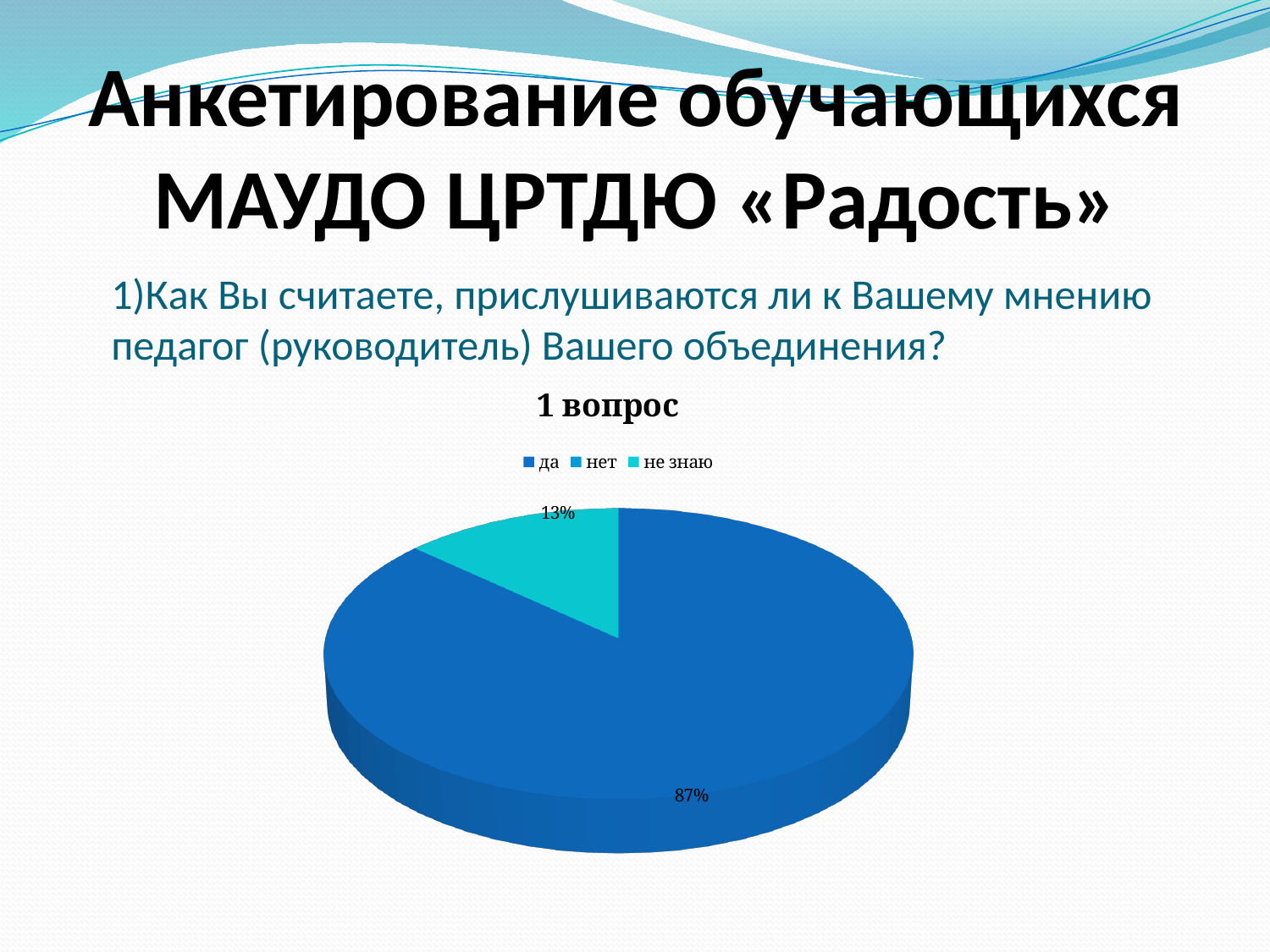
Is the share for "да" greater or less than 50%? greater How many entries does the chart legend list? 3 Which is larger, the slice for "да" or the slice for "не знаю"? да What share of the pie is labelled for the "не знаю" slice? 13% Which answer option has the largest slice of the pie? да What share of the pie is labelled for the "да" slice? 87% Which legend entry is shown in the dark blue colour? да What is the title of the chart? 1 вопрос What kind of chart is shown on the slide? pie chart What is the difference in percentage points between the "да" slice and the "не знаю" slice? 74